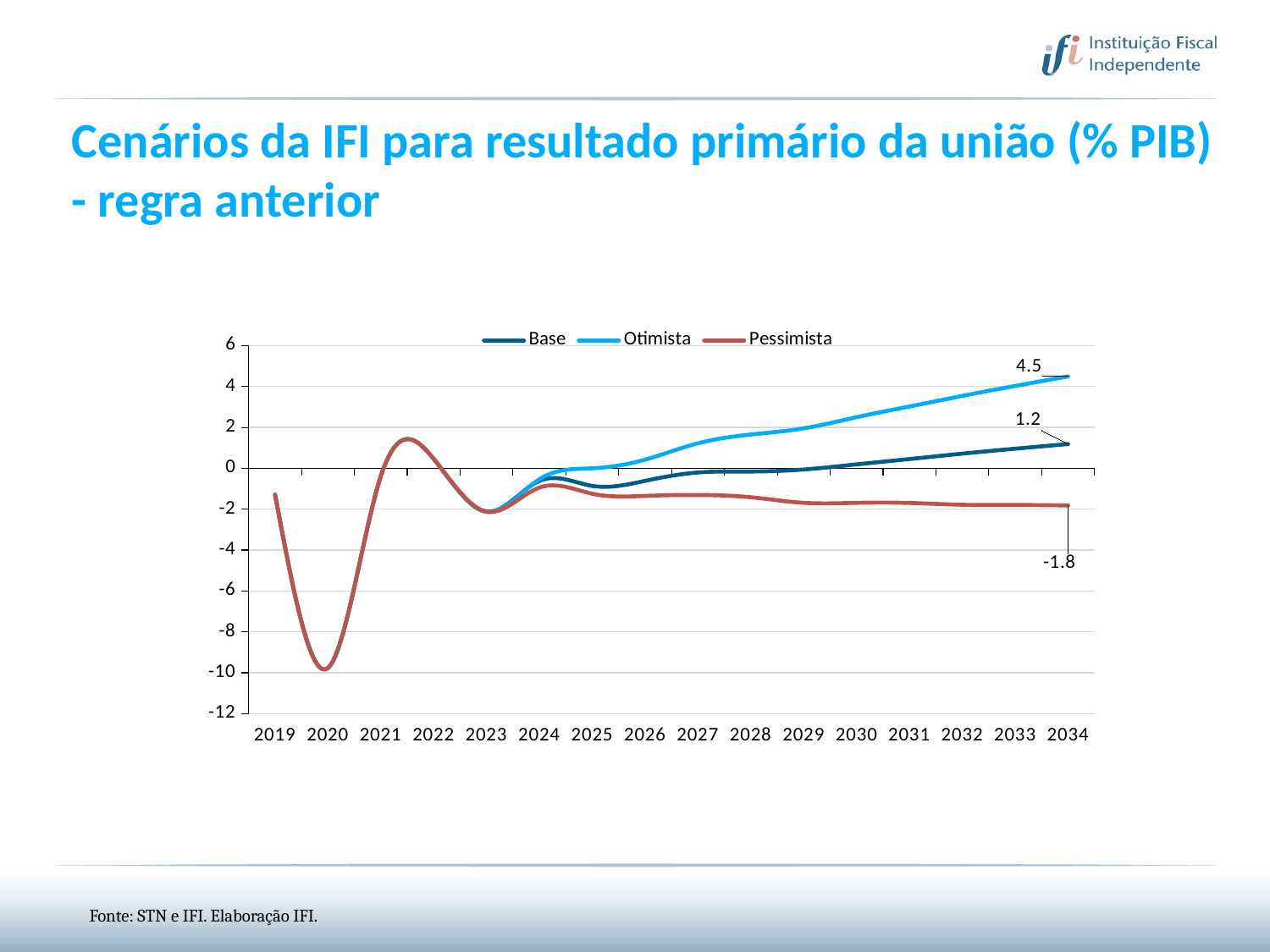
In 2034, which is larger: the Base value or the Pessimista value? Base What kind of chart is shown on the slide? line chart Does the Otimista series rise or fall from 2026 to 2034? rise What is the value of the Base series in 2034? 1.2 What is the value of the Pessimista series in 2034? -1.8 Is the value for 2020 greater or less than -8? less What is the value of the Otimista series in 2034? 4.5 Which series has the lowest value in 2034? Pessimista What is the difference between the Otimista and Base values in 2034? 3.3 What is the difference between the Base and Pessimista values in 2034? 3.0 How many series does the legend list? 3 Which series has the highest value in 2034? Otimista